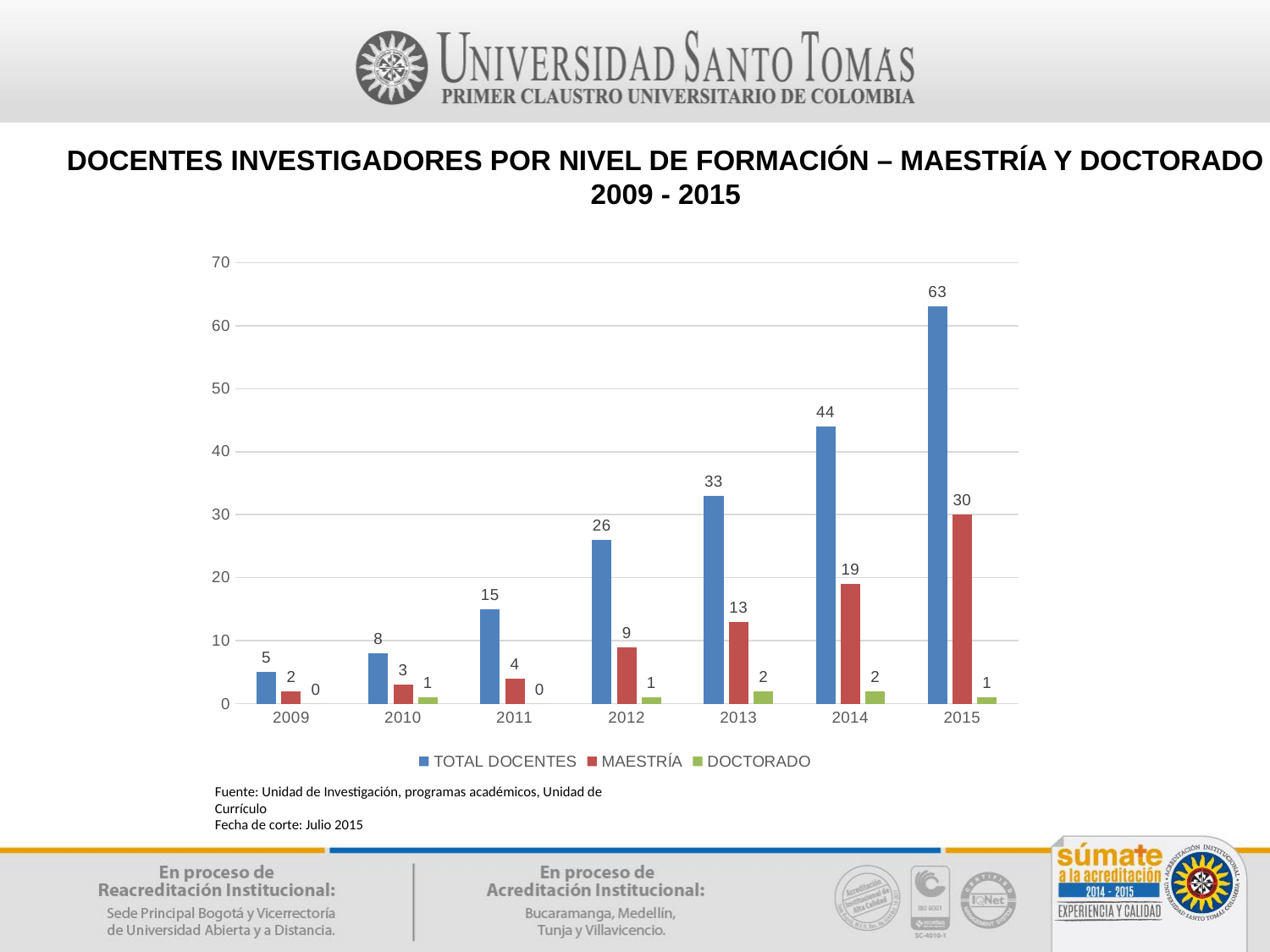
What is the difference between TOTAL DOCENTES and MAESTRÍA in 2014? 25 What is the value for TOTAL DOCENTES in 2015? 63 What is the value for MAESTRÍA in 2013? 13 How many series does the legend list? 3 What kind of chart is shown on the slide? bar chart Is the value for TOTAL DOCENTES in 2013 greater or less than 30? greater Does the value for TOTAL DOCENTES rise or fall from 2009 to 2015? rise What is the value for DOCTORADO in 2010? 1 Which is larger, MAESTRÍA in 2012 or MAESTRÍA in 2011? MAESTRÍA in 2012 Which year has the lowest value for MAESTRÍA? 2009 How many years are shown on the x axis? 7 Which year has the highest value for TOTAL DOCENTES? 2015